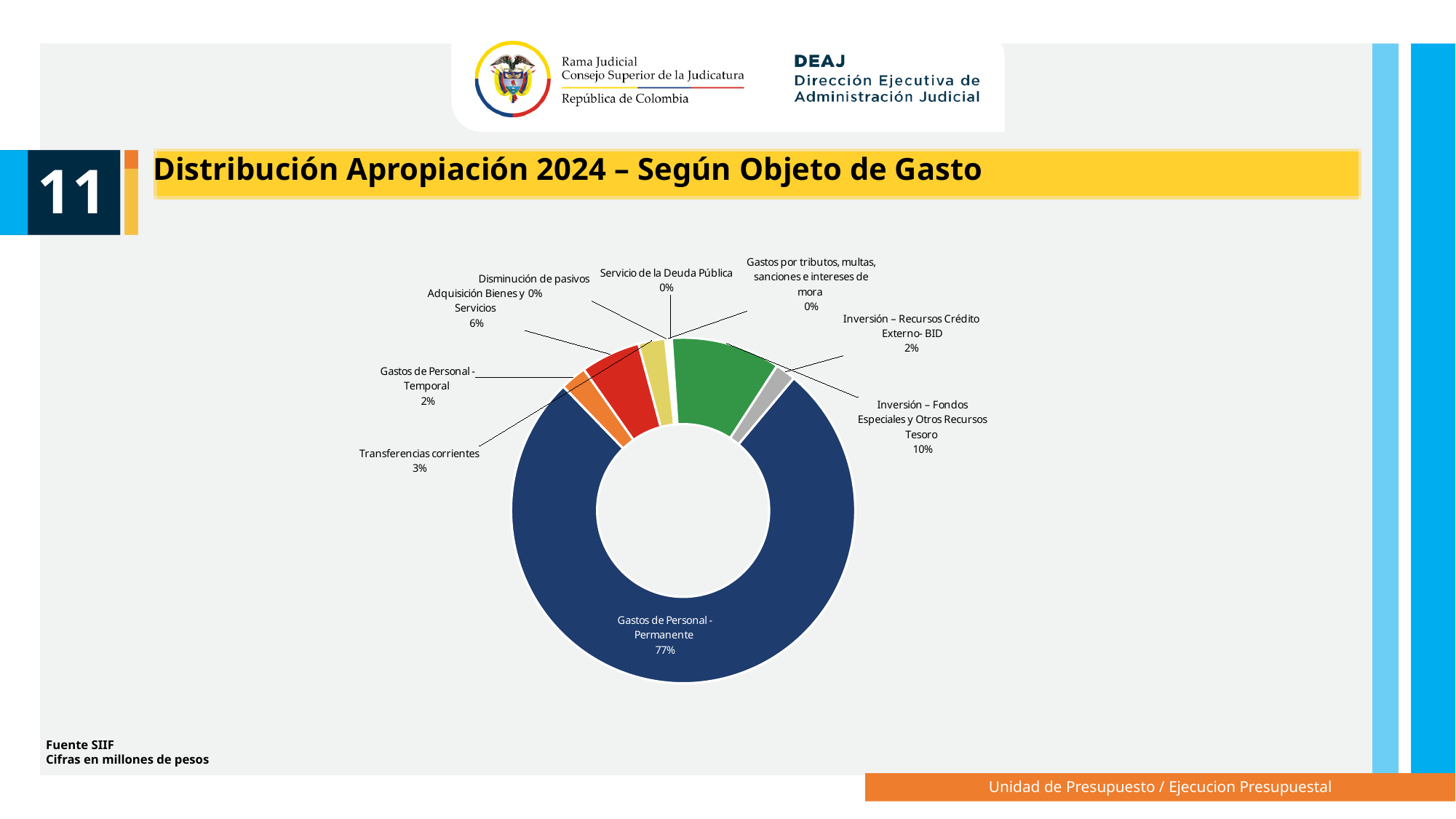
Which category has the largest share of the chart? Gastos de Personal - Permanente What kind of chart is shown on the slide? doughnut chart What is the title of the slide's chart? Distribución Apropiación 2024 – Según Objeto de Gasto What percentage is shown for Inversión – Recursos Crédito Externo- BID? 2% How many categories are labelled on the chart? 9 Which is larger, Adquisición Bienes y Servicios or Transferencias corrientes? Adquisición Bienes y Servicios What percentage is shown for Inversión – Fondos Especiales y Otros Recursos Tesoro? 10% What is the difference in percentage points between Gastos de Personal - Permanente and Inversión – Fondos Especiales y Otros Recursos Tesoro? 67 percentage points What percentage is shown for Gastos de Personal - Temporal? 2% What percentage is shown for Transferencias corrientes? 3% What percentage is shown for Adquisición Bienes y Servicios? 6% What share of the chart does Gastos de Personal - Permanente represent? 77%